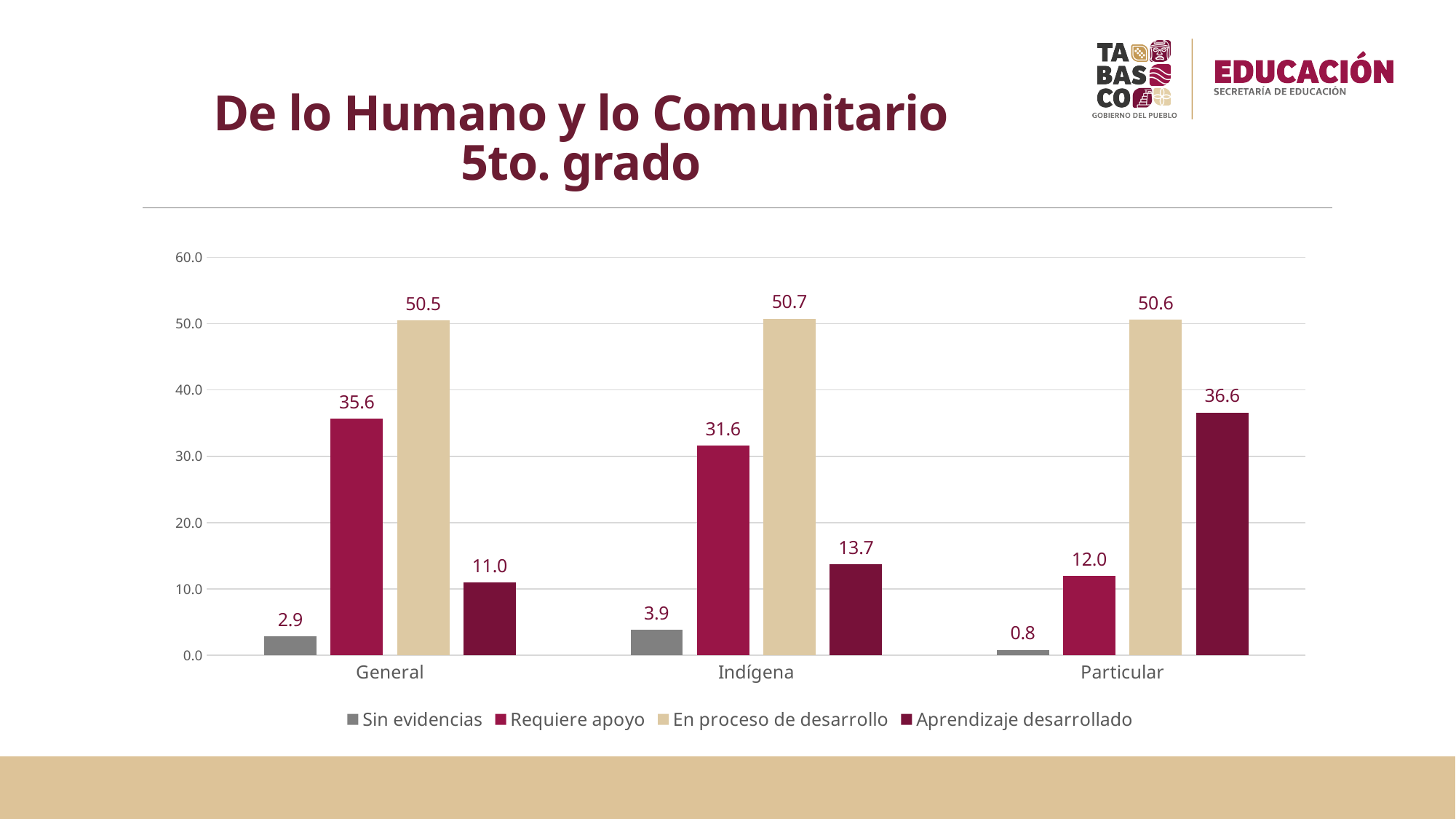
What is the value for Requiere apoyo in the General category? 35.6 Which category has the highest value for Aprendizaje desarrollado? Particular Which category has the lowest value for Sin evidencias? Particular How many categories are shown on the x axis? 3 Is the value for Requiere apoyo in the Particular category greater or less than 20.0? less What kind of chart is shown on the slide? bar chart What is the title of the slide? De lo Humano y lo Comunitario 5to. grado How many series does the legend list? 4 What is the value for Aprendizaje desarrollado in the Particular category? 36.6 Which is larger: Aprendizaje desarrollado for Indígena or Aprendizaje desarrollado for General? Indígena What is the difference between Requiere apoyo for General and Requiere apoyo for Indígena? 4.0 What is the value for Sin evidencias in the Indígena category? 3.9